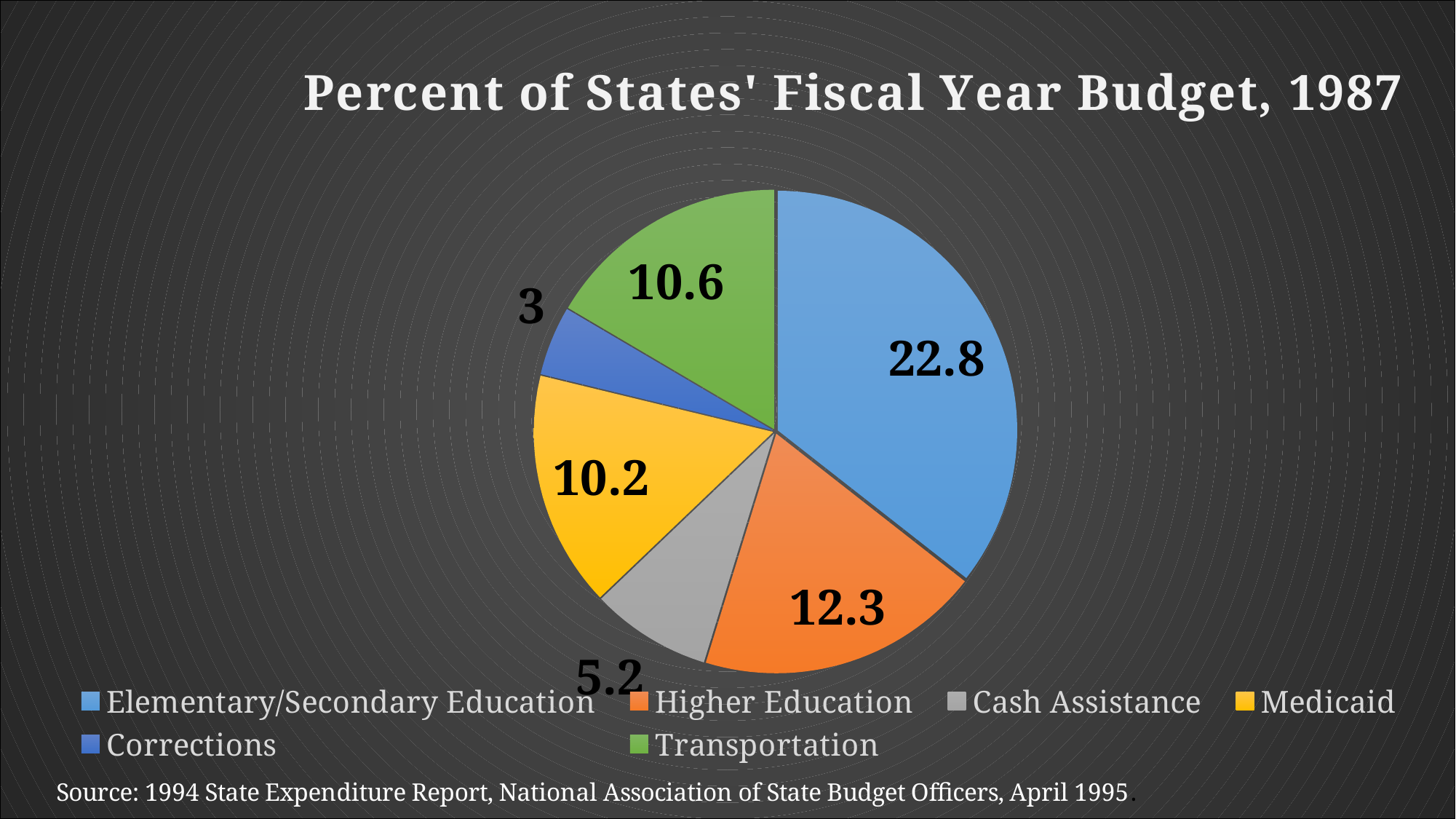
What is the title of the chart? Percent of States' Fiscal Year Budget, 1987 Which is larger, the value for Higher Education or the value for Medicaid? Higher Education How many categories are shown in the pie chart? 6 Which category has the smallest slice of the pie? Corrections What is the value for Higher Education? 12.3 What is the value for Elementary/Secondary Education? 22.8 What is the difference between the values for Elementary/Secondary Education and Higher Education? 10.5 What is the value for Transportation? 10.6 What is the value for Corrections? 3 What kind of chart is shown on the slide? Pie chart What is the value for Cash Assistance? 5.2 Which category has the largest slice of the pie? Elementary/Secondary Education